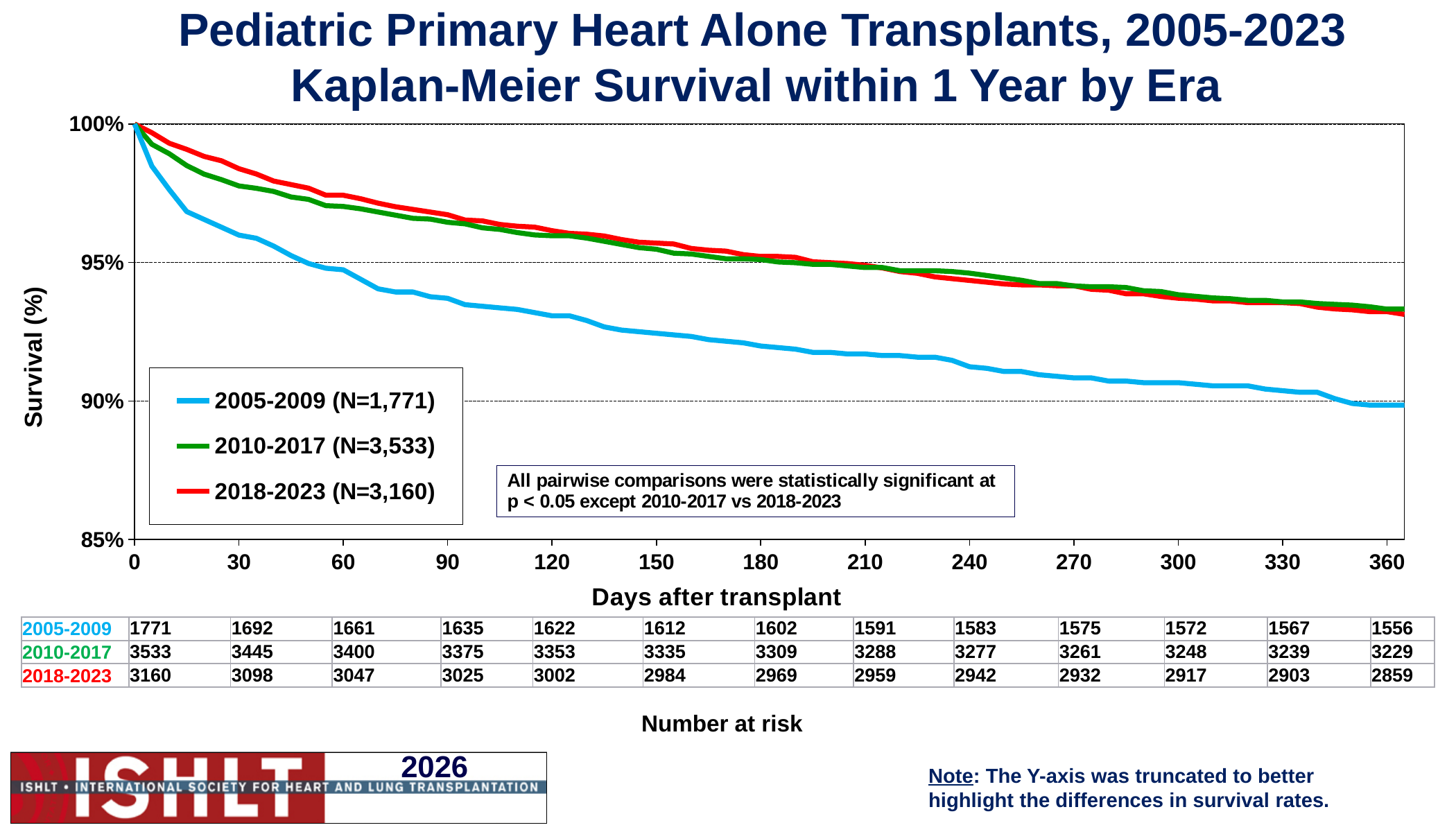
By how much does the number at risk for the 2005-2009 era fall from day 0 to day 360? 215 Do the survival curves rise or fall as days after transplant increase? Fall What is the N for the 2010-2017 era shown in the legend? 3,533 Is the survival for the 2018-2023 era at day 30 greater or less than 95%? greater What kind of chart is shown on the slide? Line chart Is the survival for the 2005-2009 era at day 180 greater or less than 95%? less What is the number at risk for the 2005-2009 era at day 90? 1635 Which era has the lowest survival at day 360? 2005-2009 At day 30, which era has higher survival: 2005-2009 or 2018-2023? 2018-2023 How many series (eras) does the legend list? 3 What is the number at risk for the 2010-2017 era at day 180? 3309 What is the number at risk for the 2018-2023 era at day 360? 2859